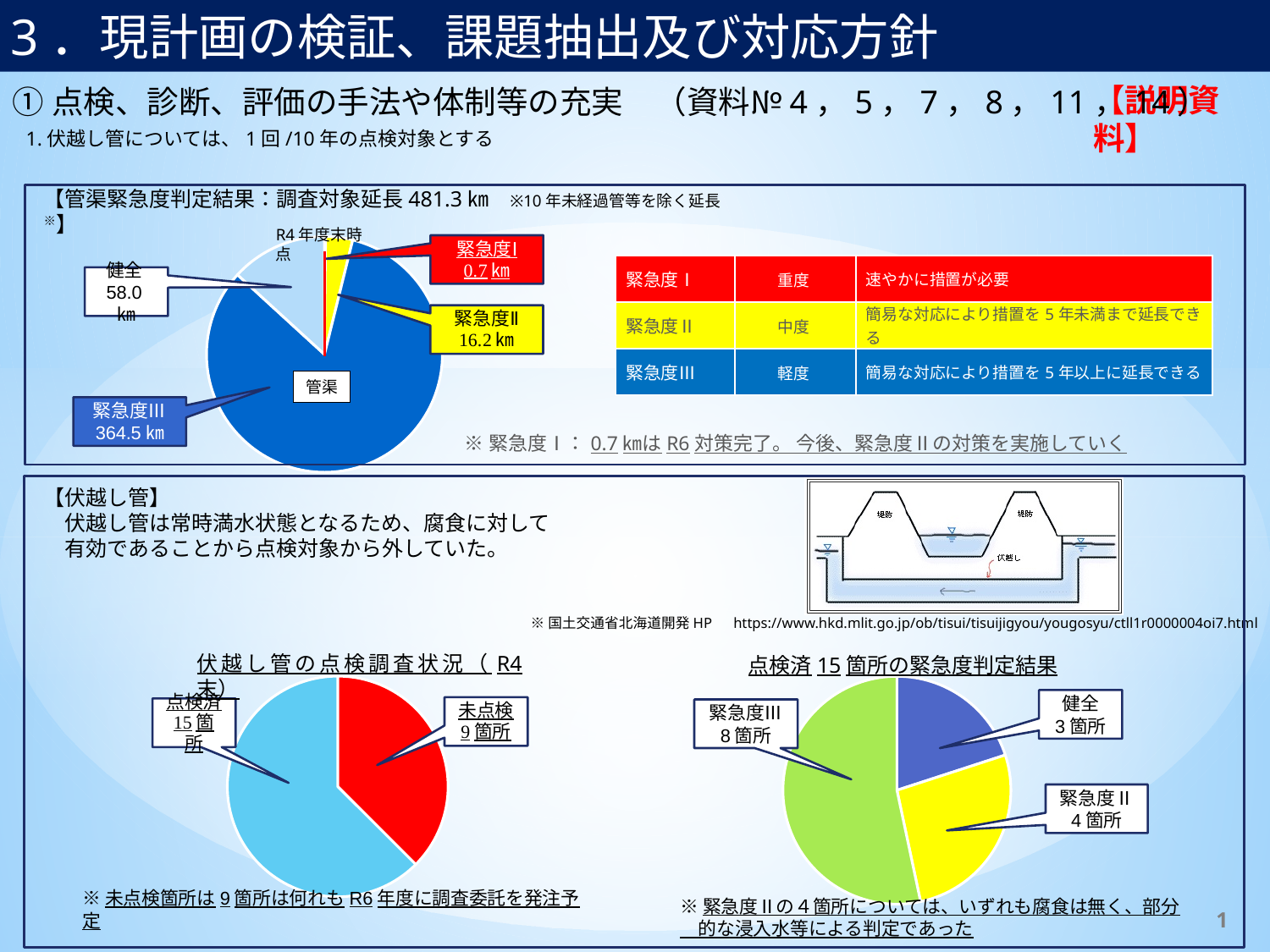
In the top pie chart (管渠緊急度判定結果), what is the difference between 健全 and 緊急度II? 41.8 km In the bottom-left pie chart (伏越し管の点検調査状況), what is the total of 点検済 and 未点検? 24箇所 What type of chart is used for 点検済15箇所の緊急度判定結果? Pie chart In the top pie chart (管渠緊急度判定結果), which category has the largest value? 緊急度III In the top pie chart (管渠緊急度判定結果), what is the value for 緊急度II? 16.2 km In the top pie chart (管渠緊急度判定結果), how many categories are shown? 4 In the top pie chart (管渠緊急度判定結果), which category has the smallest value? 緊急度I In the bottom-left pie chart (伏越し管の点検調査状況), what is the value for 未点検? 9箇所 In the bottom-left pie chart (伏越し管の点検調査状況), which is larger, 点検済 or 未点検? 点検済 In the bottom-right pie chart (点検済15箇所の緊急度判定結果), what is the value for 緊急度III? 8箇所 In the bottom-right pie chart (点検済15箇所の緊急度判定結果), which category has the smallest value? 健全 In the top pie chart (管渠緊急度判定結果), what is the value for 緊急度III? 364.5 km